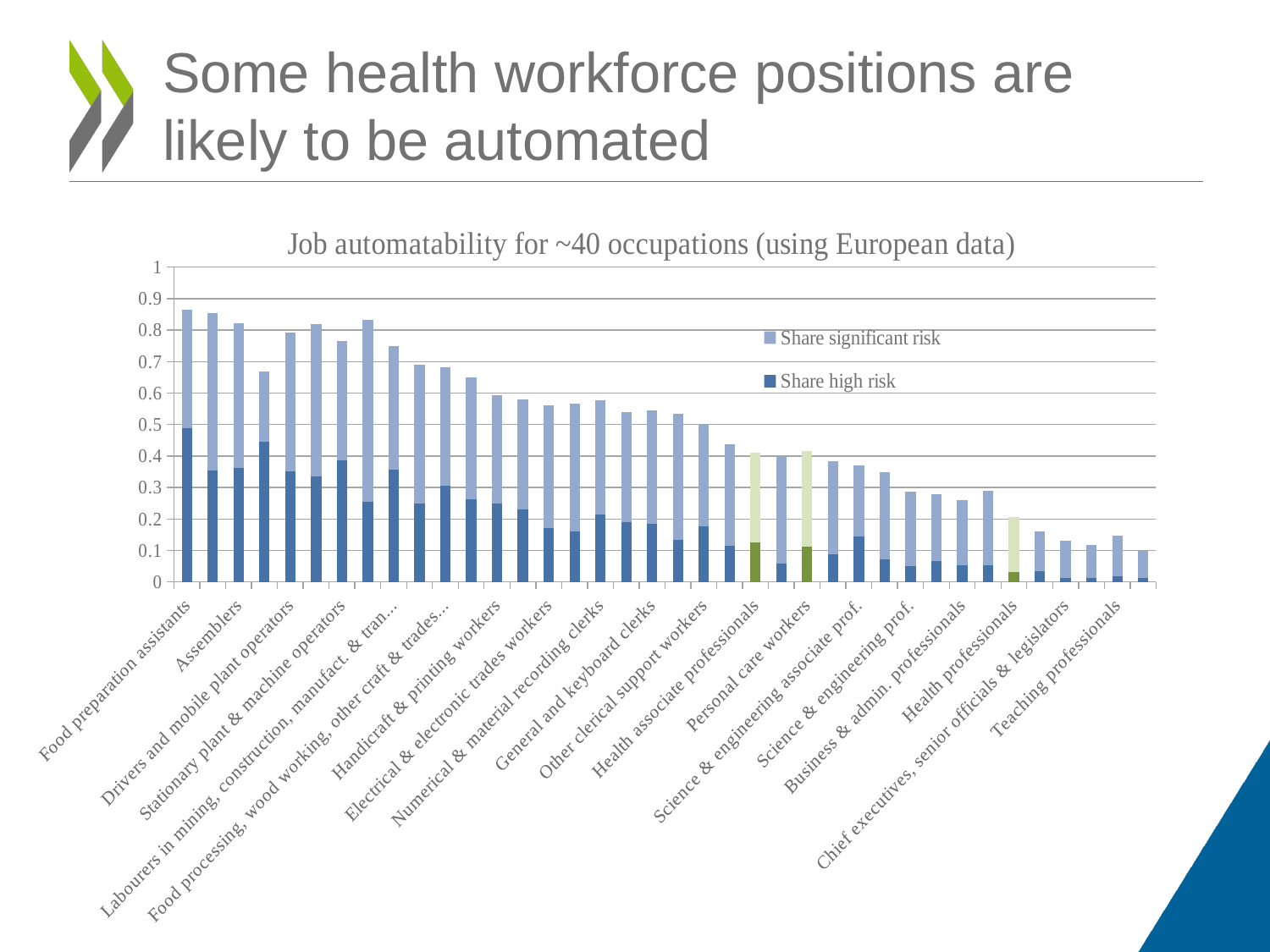
Do the total bar heights generally rise or fall moving from left to right along the x axis? Fall What are the two series named in the legend? Share significant risk; Share high risk Is the total bar height for Food preparation assistants greater or less than 0.8? greater Is the total bar height for Health associate professionals greater or less than 0.3? greater What kind of chart is shown on the slide? Stacked bar chart Is the total bar height for Personal care workers greater or less than 0.5? less What is the title of the chart? Job automatability for ~40 occupations (using European data) Which has a larger total bar, Food preparation assistants or Health professionals? Food preparation assistants How many series does the legend list? 2